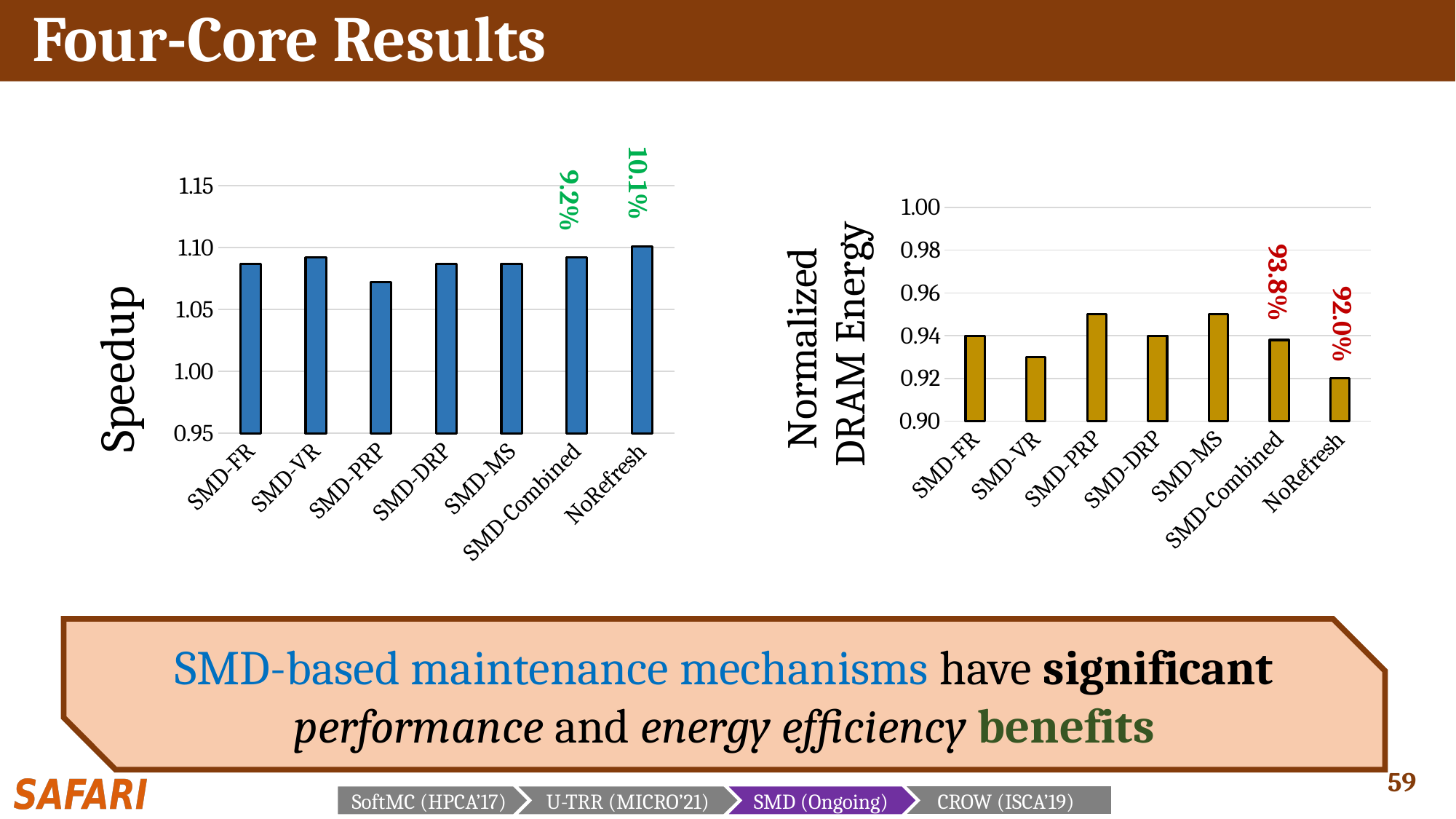
In the Speedup chart, which category has the lowest speedup? SMD-PRP In the Normalized DRAM Energy chart, what percentage label is printed above the SMD-Combined bar? 93.8% In the Normalized DRAM Energy chart, which category has the lowest normalized DRAM energy? NoRefresh In the Speedup chart, which category has the highest speedup? NoRefresh In the Normalized DRAM Energy chart, is the value for SMD-VR greater or less than 0.94? less In the Normalized DRAM Energy chart, which is larger, the value for SMD-PRP or the value for SMD-VR? SMD-PRP What kind of chart is the Speedup chart on the left? bar chart How many categories are shown on the x axis of the Speedup chart? 7 In the Speedup chart, is the speedup for SMD-PRP greater or less than 1.05? greater What is the y-axis label of the chart on the right? Normalized DRAM Energy In the Speedup chart, what percentage label is printed above the NoRefresh bar? 10.1% In the Speedup chart, what percentage label is printed above the SMD-Combined bar? 9.2%